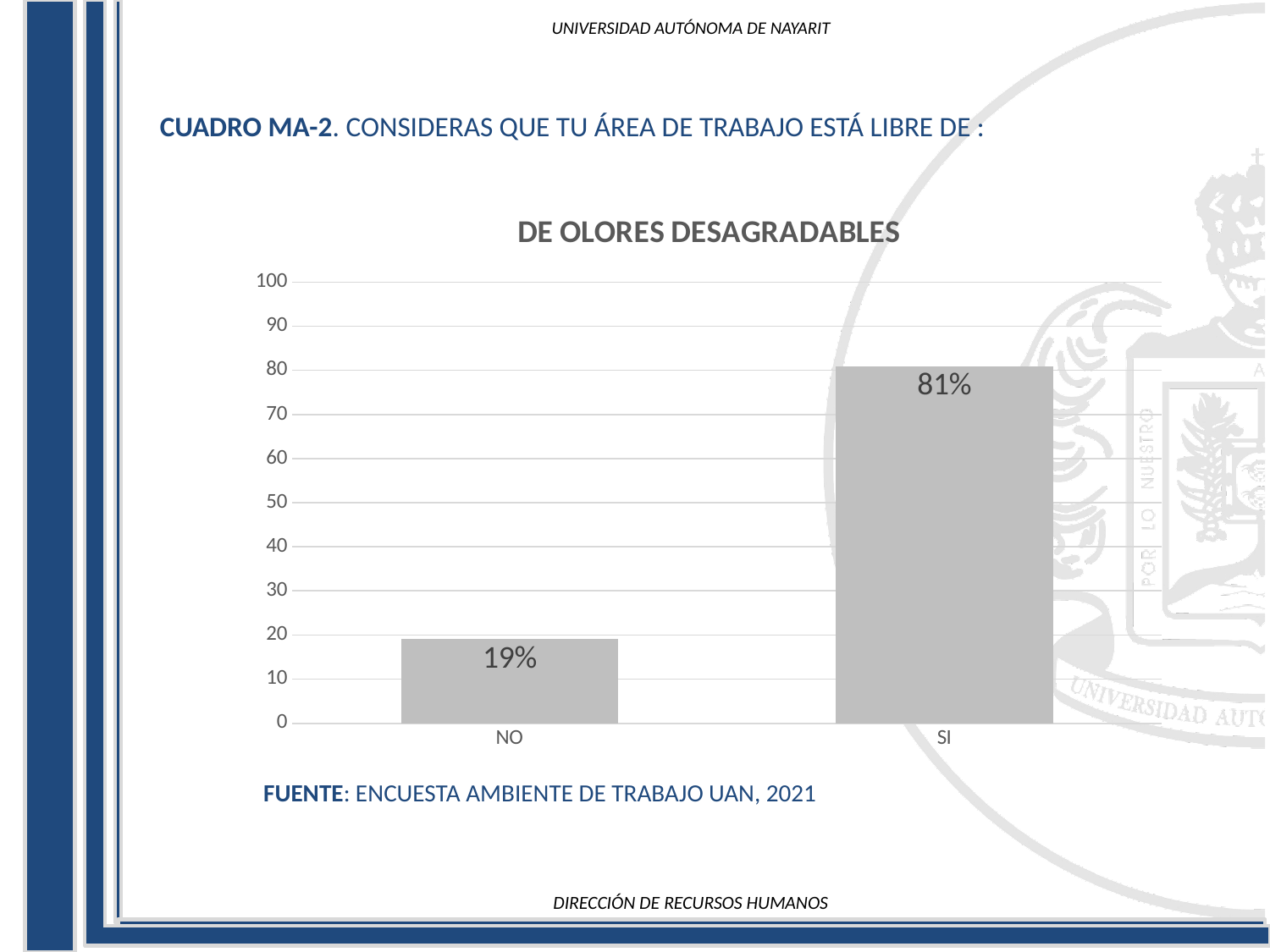
What is the difference between the values for SI and NO? 62% Which category has the lowest value? NO What is the title of the chart? DE OLORES DESAGRADABLES Is the value for NO greater or less than 30? less Which category has the highest value? SI How many categories are shown on the x axis? 2 What kind of chart is shown? bar chart Is the value for SI greater or less than 50? greater What is the maximum value shown on the y axis? 100 Which is larger, the value for NO or the value for SI? SI What is the value for SI? 81% What is the value for NO? 19%